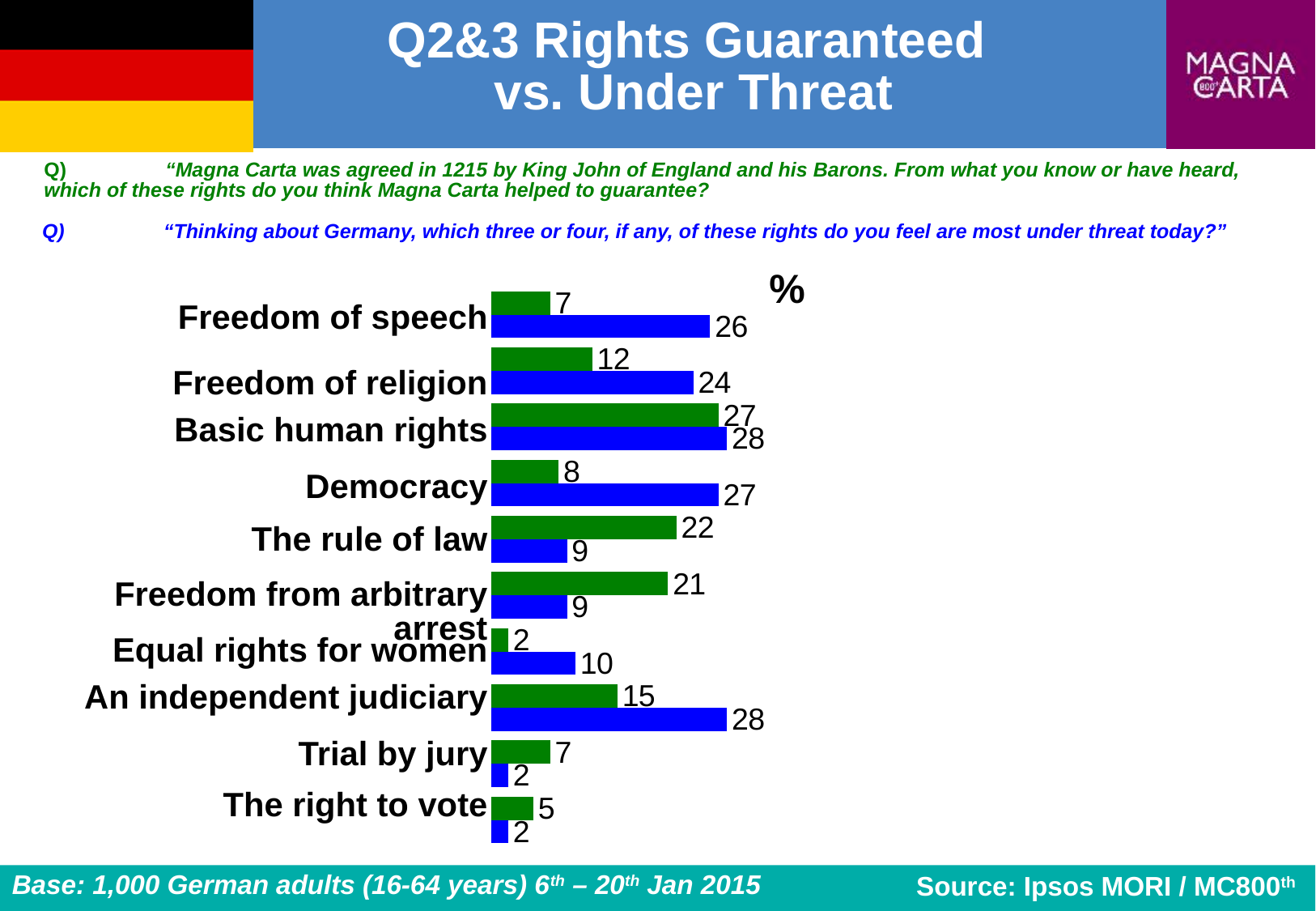
For Freedom of religion, which is larger: the green bar or the blue bar? the blue bar What is the value of the blue bar for Democracy? 27 How many categories are shown on the chart? 10 What kind of chart is shown on the slide? bar chart What is the value of the green bar for The rule of law? 22 What is the value of the green bar for Freedom of speech? 7 For Trial by jury, which is larger: the green bar or the blue bar? the green bar Which category has the highest green bar value? Basic human rights What is the difference between the blue and green bar values for Freedom of speech? 19 Which category has the lowest green bar value? Equal rights for women What is the value of the blue bar for An independent judiciary? 28 What is the difference between the green and blue bar values for The rule of law? 13